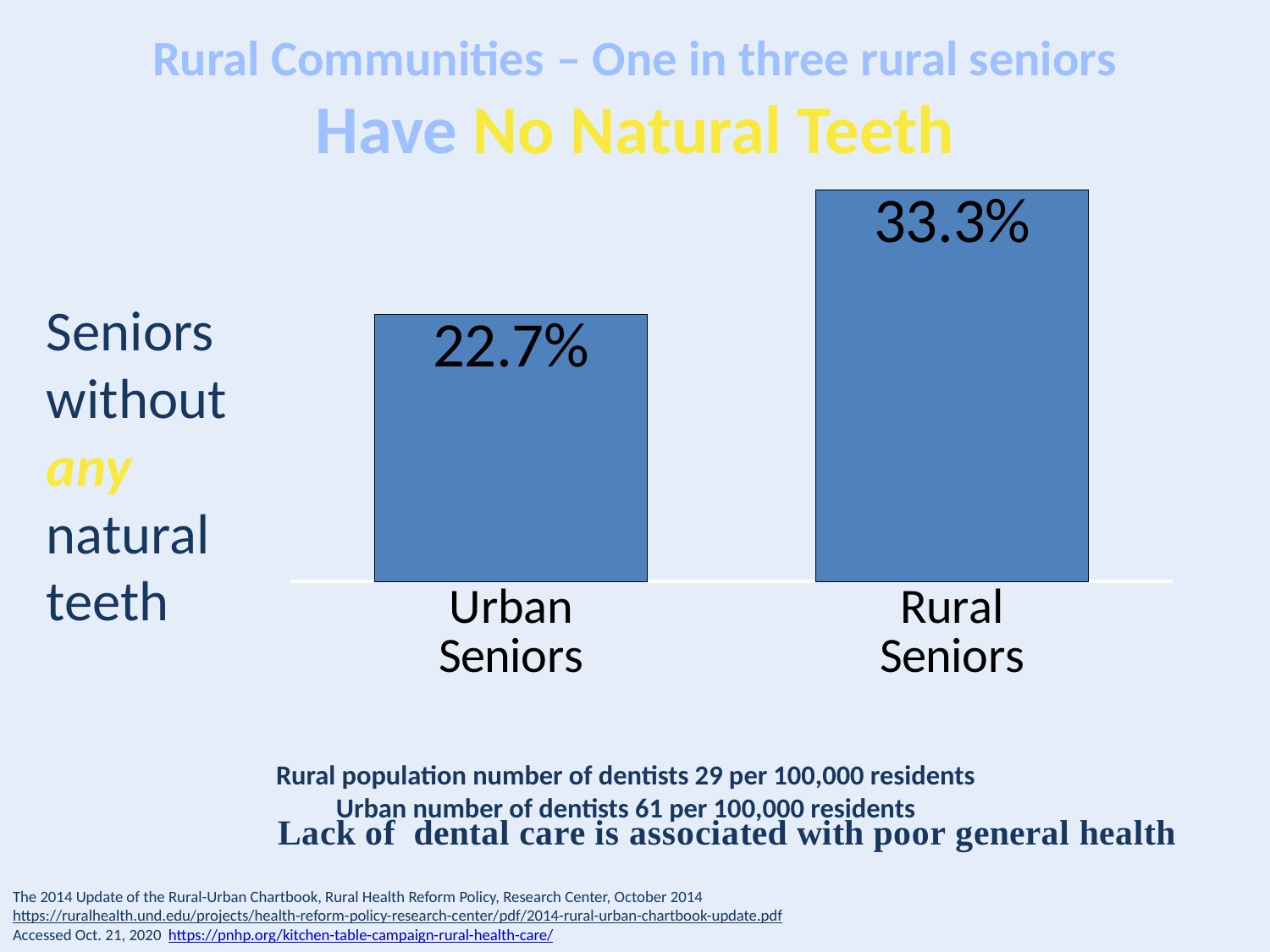
What does the label to the left of the chart say the bars measure? Seniors without any natural teeth Which category has the lower percentage of seniors without any natural teeth? Urban Seniors What kind of chart is shown on the slide? bar chart What percentage of Rural Seniors are without any natural teeth? 33.3% What colour are the bars in the chart? blue Is the value for Rural Seniors larger or smaller than the value for Urban Seniors? larger Which category has the higher percentage of seniors without any natural teeth? Rural Seniors What percentage of Urban Seniors are without any natural teeth? 22.7% How many categories are shown in the chart? 2 What is the difference in percentage points between Rural Seniors and Urban Seniors without any natural teeth? 10.6 Do the values rise or fall from Urban Seniors to Rural Seniors? rise